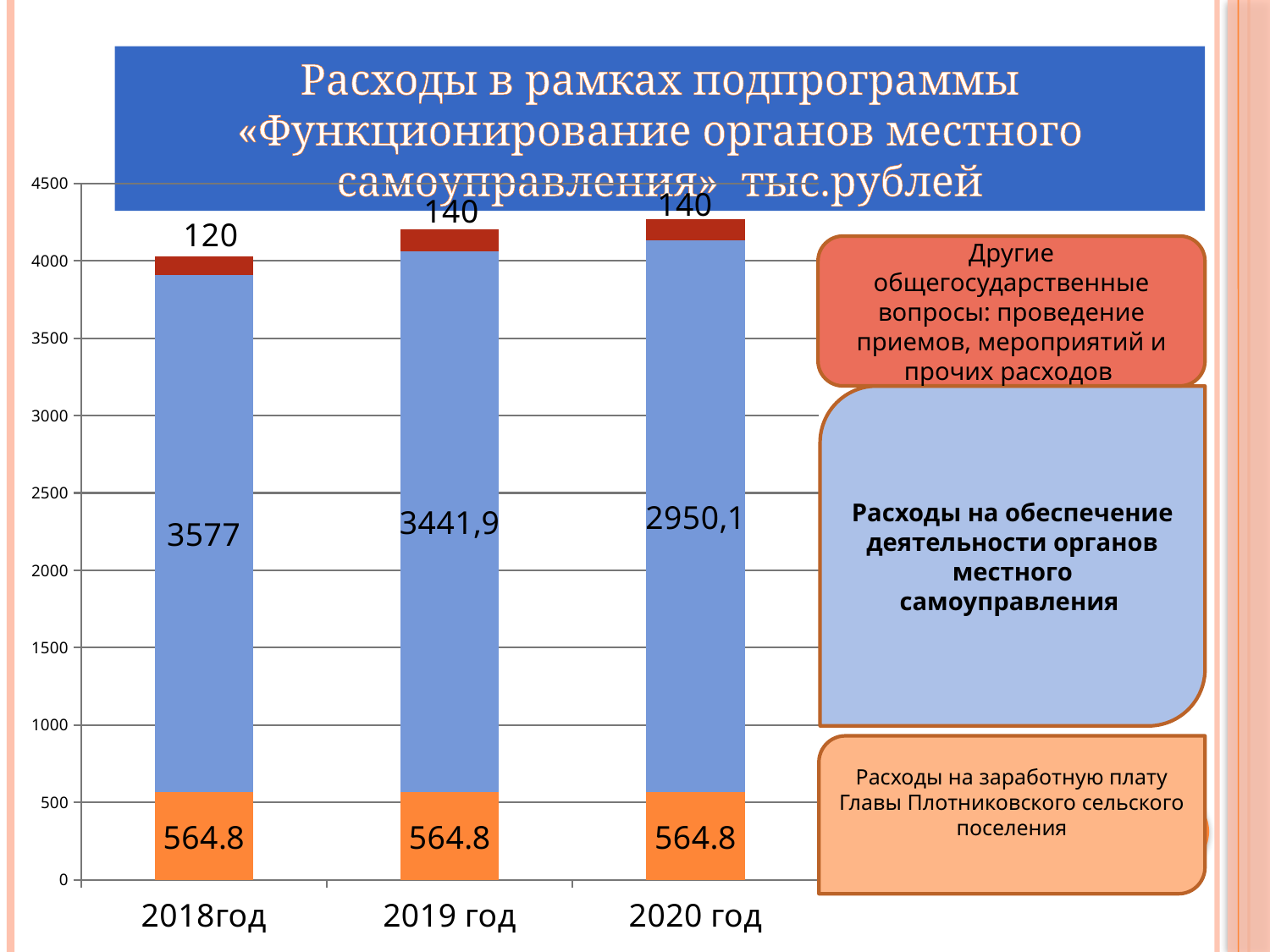
What kind of chart is shown on the slide? stacked bar chart What is the value of the orange segment (Расходы на заработную плату Главы) for 2018год? 564.8 In which year is the red top segment (Другие общегосударственные вопросы) the smallest? 2018год How many years (categories) are shown on the x axis? 3 What is the value of the red top segment (Другие общегосударственные вопросы) for 2019 год? 140 What is the value of the blue segment (Расходы на обеспечение деятельности органов местного самоуправления) for 2018год? 3577 What is the value of the blue segment for 2020 год? 2950,1 Is the total height of the 2020 год bar greater or less than 4000? greater